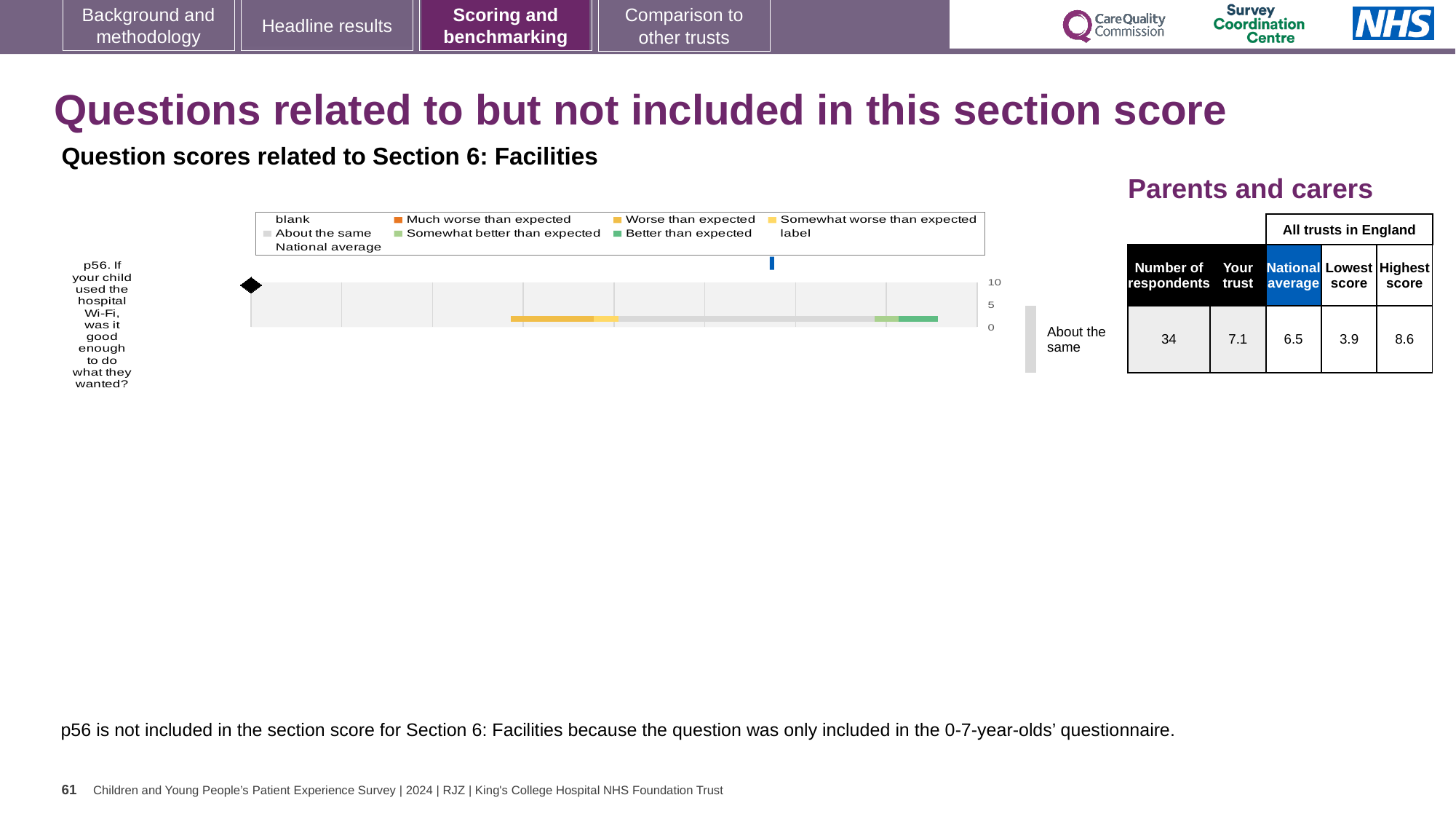
How many respondents answered question p56? 34 What is the lowest score among all trusts in England for question p56? 3.9 What is the highest score among all trusts in England for question p56? 8.6 How many questions are plotted in the chart on the slide? 1 Which is larger for question p56, the 'Your trust' score or the national average? Your trust What is the highest value shown on the chart's score axis? 10 What is the 'Your trust' score for question p56? 7.1 What kind of chart is shown on the slide for question p56? Bar chart What is the difference between the highest score and the lowest score for question p56? 4.7 What is the national average score for question p56? 6.5 Which benchmark category is shown next to the chart for question p56? About the same Which question is plotted in the chart on the slide? p56. If your child used the hospital Wi-Fi, was it good enough to do what they wanted?